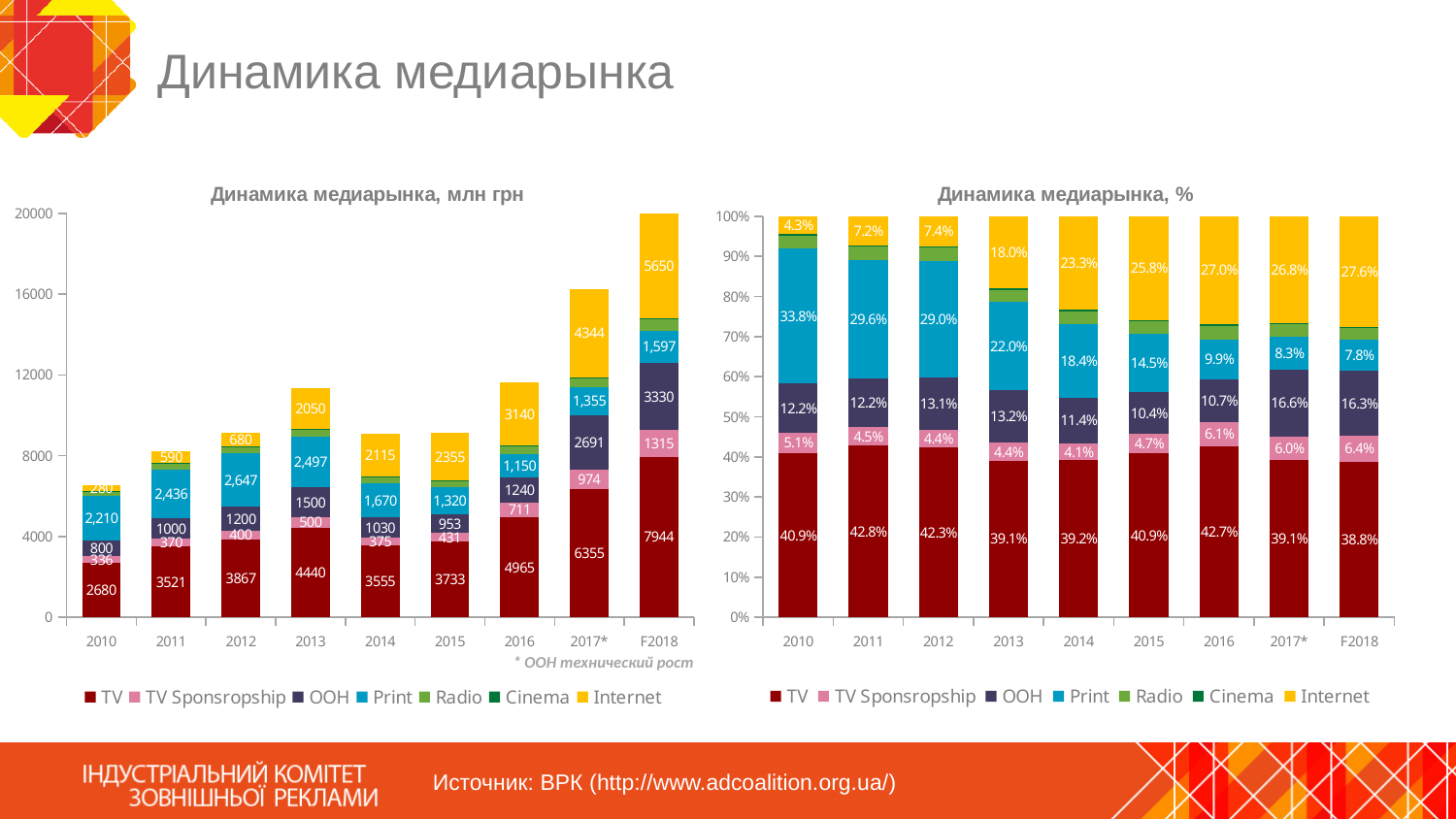
In the chart 'Динамика медиарынка, млн грн', is the total height of the 2016 bar greater or less than 8000? greater In the chart 'Динамика медиарынка, %', does the Print share rise or fall from 2010 to F2018? fall In the chart 'Динамика медиарынка, млн грн', which year has the highest TV value? F2018 In the chart 'Динамика медиарынка, млн грн', what is the difference between the Internet values for F2018 and 2017*? 1306 In the chart 'Динамика медиарынка, %', which is larger, the Print share in 2010 or the Internet share in 2010? Print share in 2010 In the chart 'Динамика медиарынка, %', what is the OOH share for 2017*? 16.6% In the chart 'Динамика медиарынка, млн грн', what is the TV value for 2016? 4965 How many series does the legend of the chart 'Динамика медиарынка, млн грн' list? 7 In the chart 'Динамика медиарынка, %', what is the Internet share for 2014? 23.3% In the chart 'Динамика медиарынка, %', which year has the lowest Print share? F2018 In the chart 'Динамика медиарынка, млн грн', what is the Print value for 2012? 2,647 In the chart 'Динамика медиарынка, млн грн', what is the Internet value for F2018? 5650